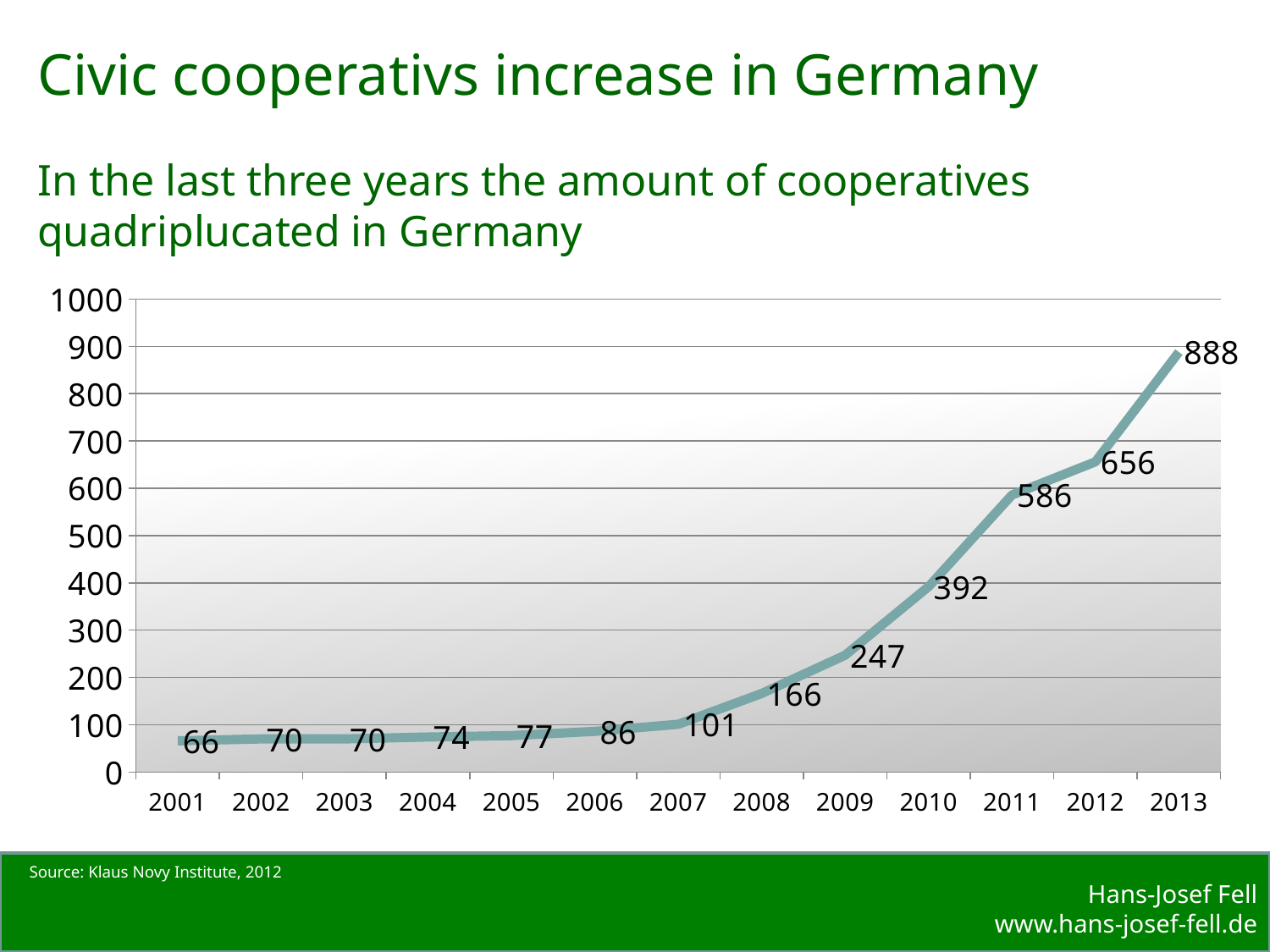
Is the value for 2012 greater or less than 600? greater Which year has the highest value? 2013 Which year has the lowest value? 2001 What is the difference between the values for 2013 and 2012? 232 Do the values rise or fall from 2001 to 2013? rise What is the value for 2009? 247 What is the value for 2001? 66 How many years are plotted on the chart? 13 Which is larger, the value for 2008 or the value for 2007? 2008 What is the difference between the values for 2011 and 2010? 194 What kind of chart is shown on the slide? line chart What is the value for 2013? 888